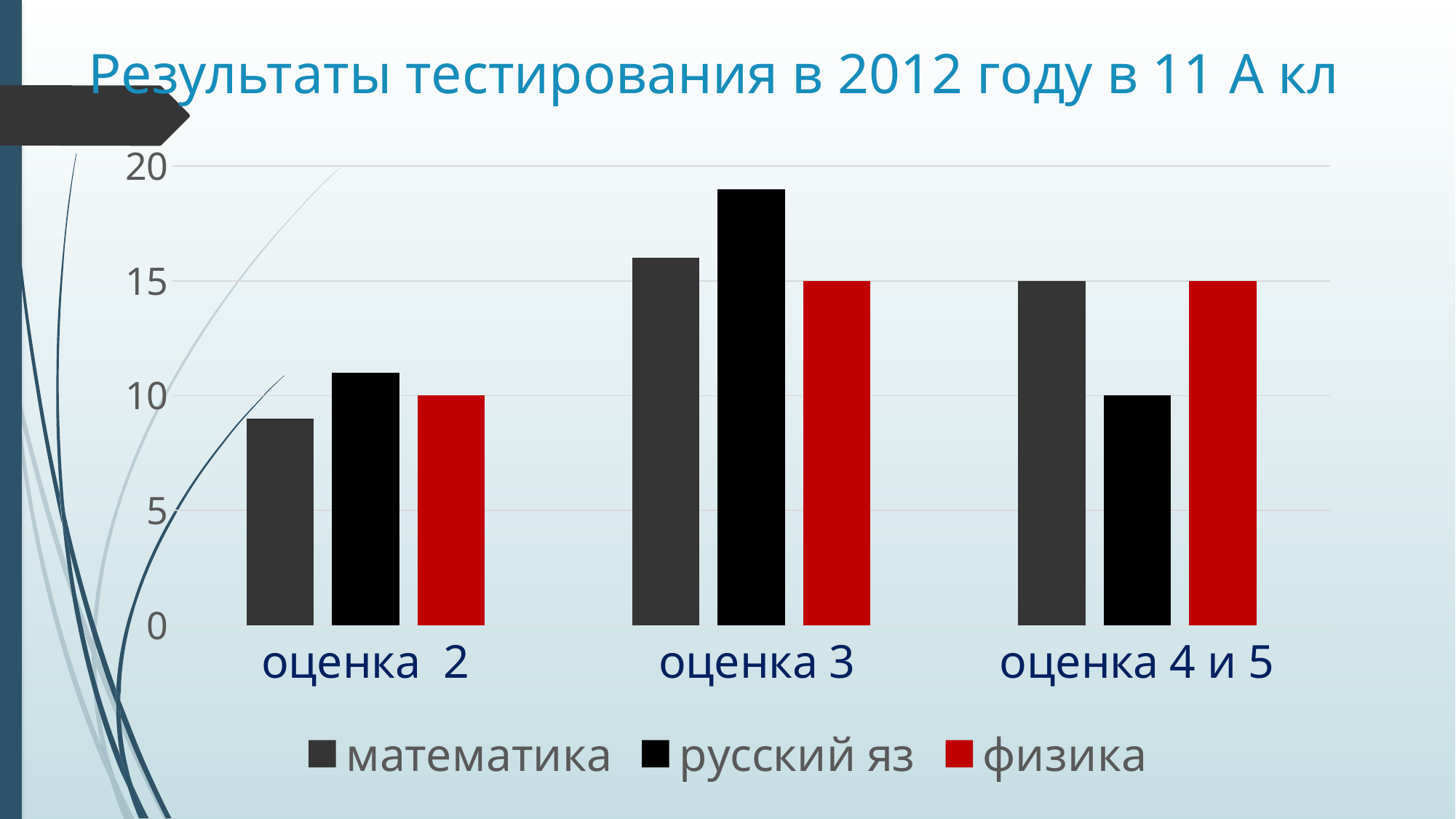
What is the title of the chart on the slide? Результаты тестирования в 2012 году в 11 А кл In the category оценка 3, which is larger: математика or русский яз? русский яз How many categories are shown on the x axis of the chart? 3 How many series does the chart legend list? 3 What is the value for физика in the category оценка 3? 15 What is the value for физика in the category оценка 2? 10 Which series has the highest bar in the category оценка 3? русский яз Is the value for математика in the category оценка 2 greater or less than 10? less Is the value for русский яз in the category оценка 3 greater or less than 15? greater Which series has the lowest bar in the category оценка 4 и 5? русский яз What kind of chart is shown on the slide? bar chart What is the value for русский яз in the category оценка 4 и 5? 10